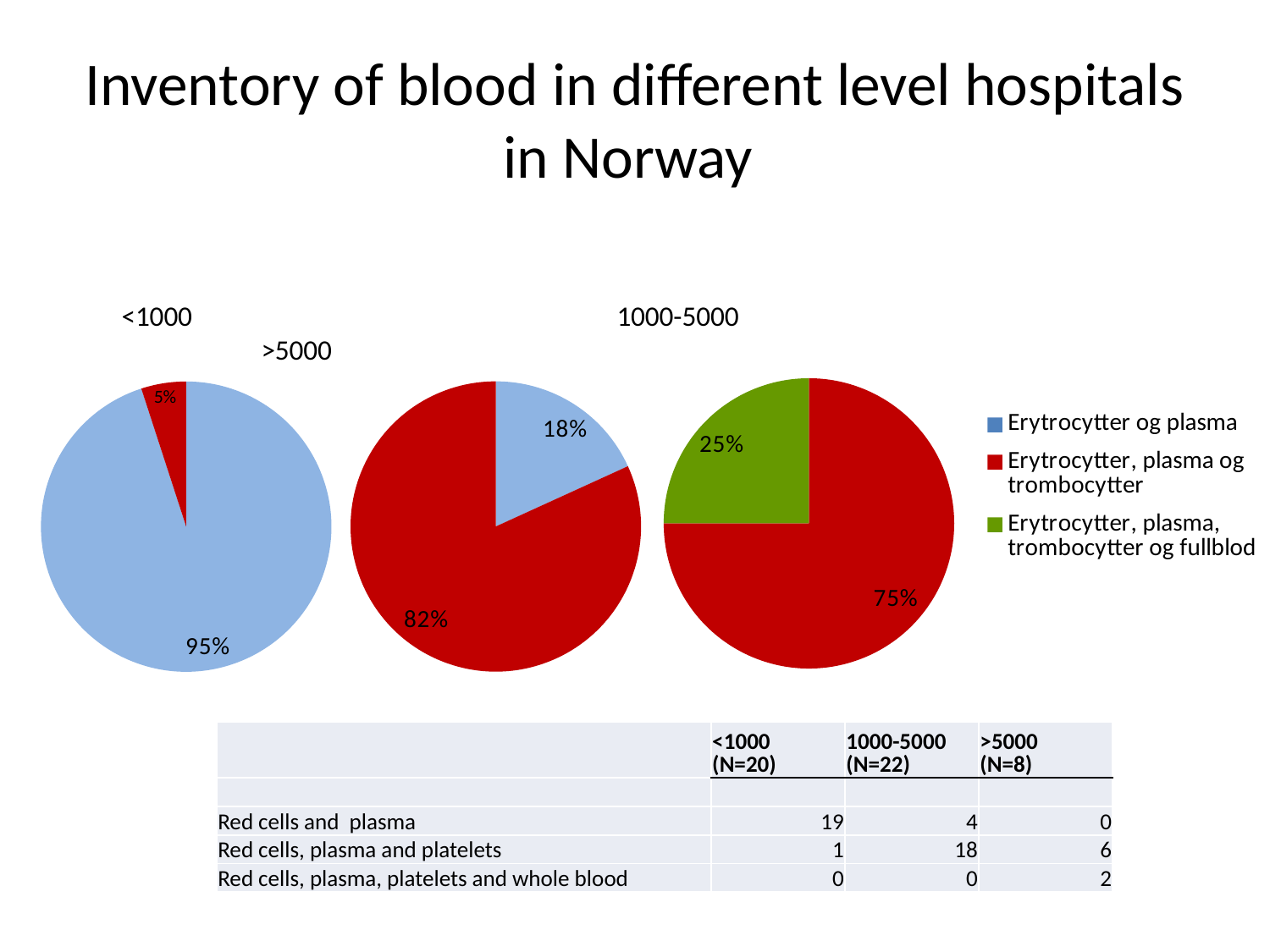
How many entries does the shared legend list for the pie charts? 3 In the "<1000" pie chart, which slice is the smallest? Erytrocytter, plasma og trombocytter In the ">5000" pie chart, what is the difference in percentage points between the Erytrocytter, plasma og trombocytter slice and the Erytrocytter, plasma, trombocytter og fullblod slice? 50 percentage points Which is larger: the Erytrocytter og plasma share in the "<1000" pie chart or the Erytrocytter og plasma share in the "1000-5000" pie chart? The "<1000" pie chart In the ">5000" pie chart, what share is labelled for the Erytrocytter, plasma, trombocytter og fullblod slice? 25% What type of chart is used for the "1000-5000" chart? Pie chart In the "<1000" pie chart, what share is labelled for the Erytrocytter og plasma slice? 95% In the "<1000" pie chart, what share is labelled for the Erytrocytter, plasma og trombocytter slice? 5% In the "1000-5000" pie chart, which slice is the largest? Erytrocytter, plasma og trombocytter